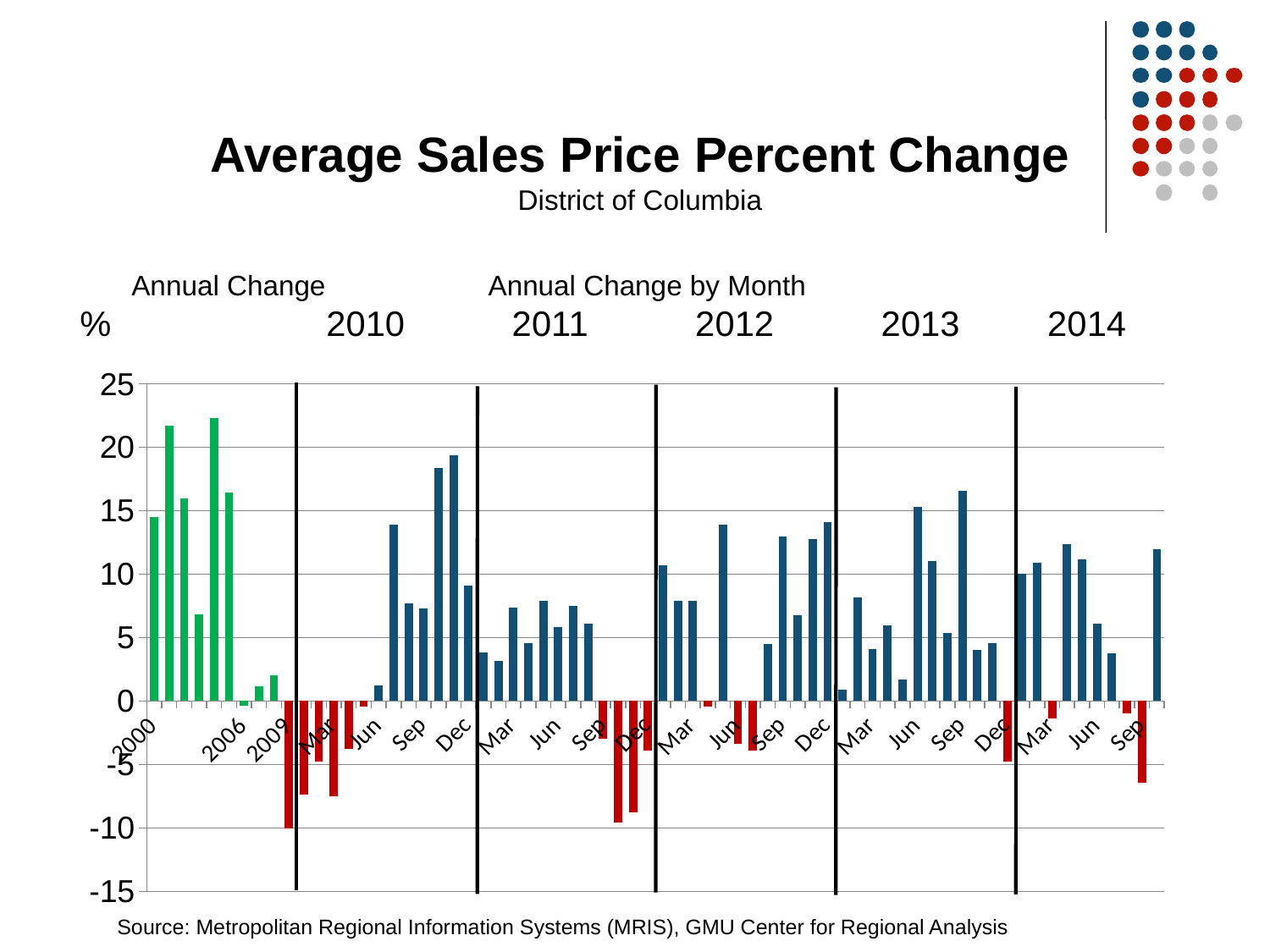
What kind of chart is shown on the slide? bar chart What is the title of the chart? Average Sales Price Percent Change Is the last bar in the 2014 section greater or less than 5? greater Is the lowest bar in the 2010 section greater or less than -5? less Which area does the chart cover, according to the subtitle? District of Columbia Is the tallest green Annual Change bar greater or less than 20? greater Which is higher, the tallest bar in the 2010 section or the tallest bar in the 2011 section? 2010 How many year sections are shown in the Annual Change by Month part of the chart? 5 In the 2014 section, do the monthly values generally rise or fall from Mar to Sep? fall